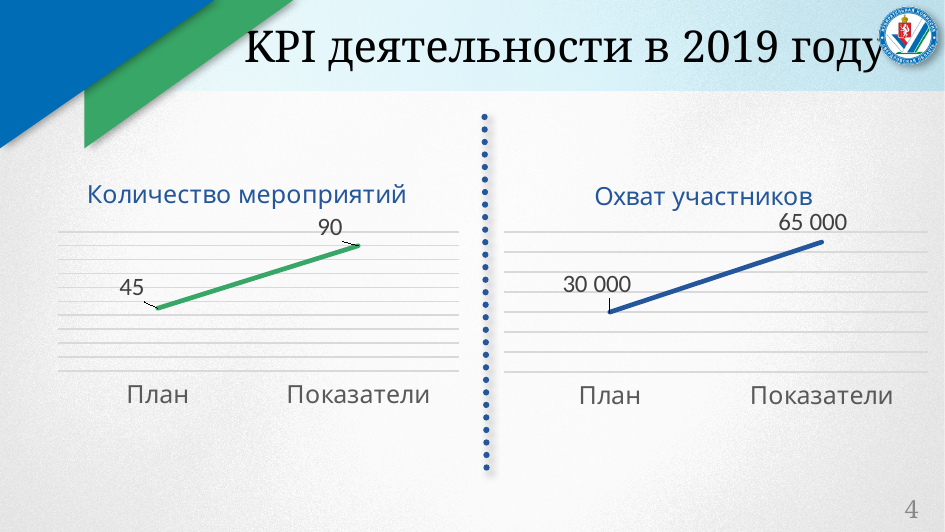
In the chart titled "Количество мероприятий", what is the value for "План"? 45 In the chart titled "Количество мероприятий", which category has the higher value, "План" or "Показатели"? Показатели What colour is the line in the chart titled "Количество мероприятий"? green In the chart titled "Охват участников", what is the difference between the values for "Показатели" and "План"? 35 000 In the chart titled "Количество мероприятий", what is the difference between the values for "Показатели" and "План"? 45 How many categories are shown on the x axis of the chart titled "Охват участников"? 2 In the chart titled "Охват участников", what is the value for "План"? 30 000 In the chart titled "Охват участников", which category has the lowest value? План What kind of chart is the chart titled "Количество мероприятий"? line chart In the chart titled "Количество мероприятий", what is the value for "Показатели"? 90 In the chart titled "Охват участников", what is the value for "Показатели"? 65 000 In the chart titled "Охват участников", do the values rise or fall from "План" to "Показатели"? rise